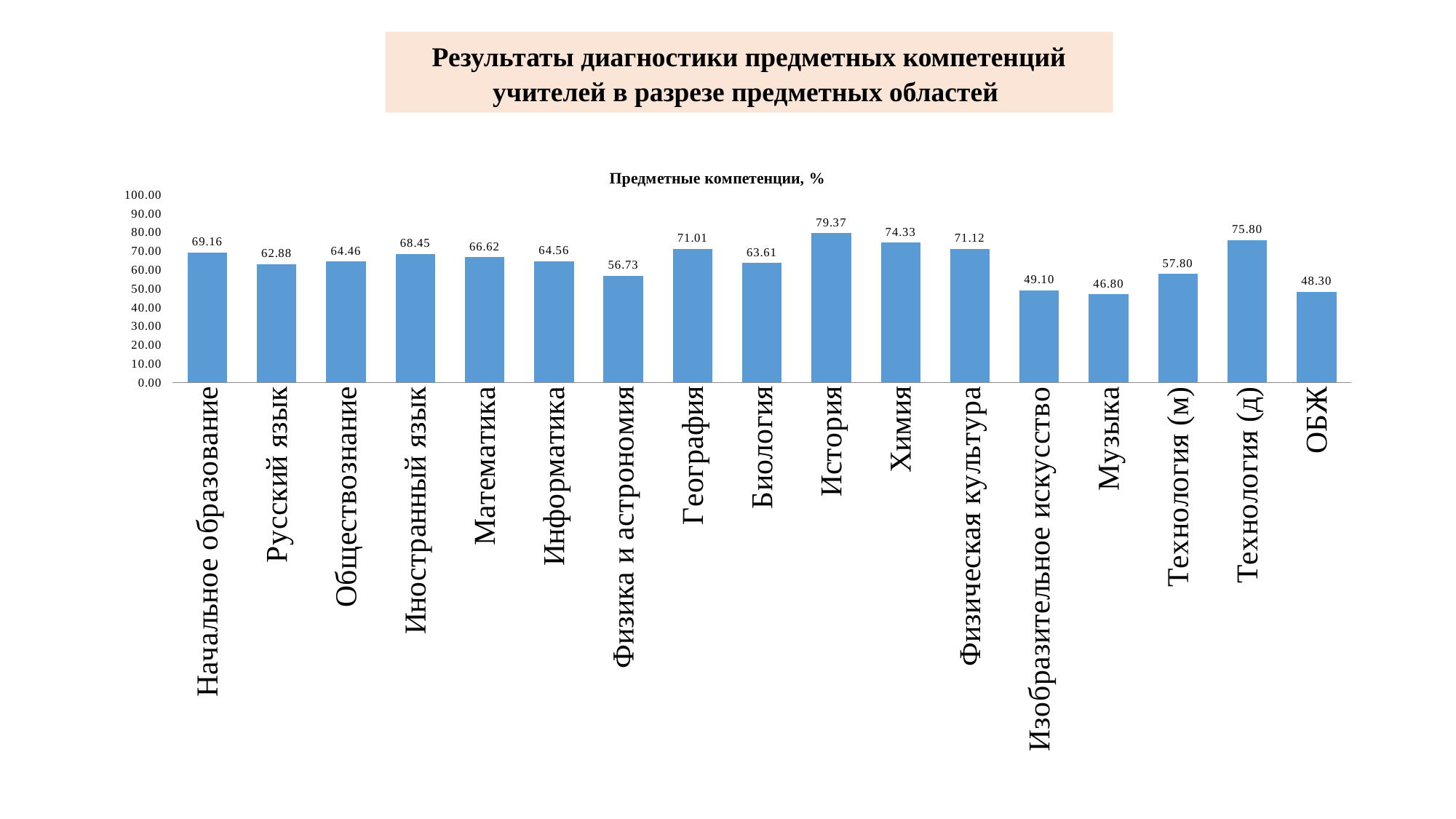
What is the value for Музыка? 46.80 What is the title shown above the chart's plot area? Предметные компетенции, % Which has a larger value, Химия or География? Химия What is the value for Технология (д)? 75.80 What is the difference between the values for История and Музыка? 32.57 How many subject areas are shown in the chart? 17 What type of chart is shown on the slide? Bar chart What is the value for Физика и астрономия? 56.73 Which subject area has the highest value? История What is the value for История? 79.37 Which subject area has the lowest value? Музыка What is the difference between the values for Технология (д) and Технология (м)? 18.00